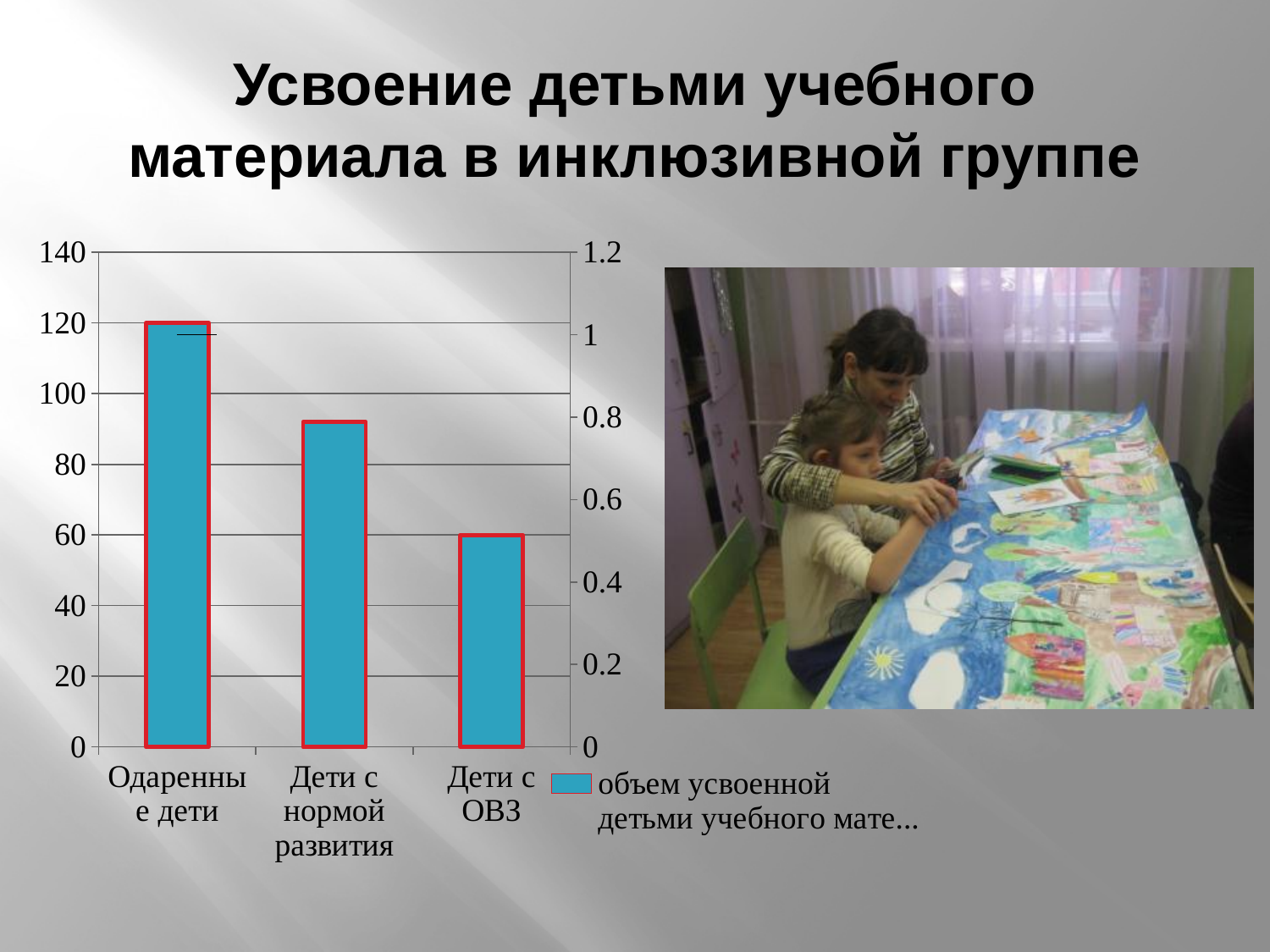
Is the value for Дети с нормой развития greater or less than 100 on the left axis? less Which is larger: the value for Одаренные дети or the value for Дети с нормой развития? Одаренные дети How many series does the chart's legend list? 1 What value on the left axis does the bar for Одаренные дети reach? 120 What kind of chart is shown on the slide? bar chart Is the value for Дети с нормой развития greater or less than 80 on the left axis? greater Is the value for Дети с ОВЗ greater or less than 80 on the left axis? less Which category has the lowest bar in the chart? Дети с ОВЗ What is the title of the slide containing the chart? Усвоение детьми учебного материала в инклюзивной группе How many categories are plotted on the x axis of the chart? 3 Do the bar values rise or fall from left to right across the categories? fall Which category has the highest bar in the chart? Одаренные дети